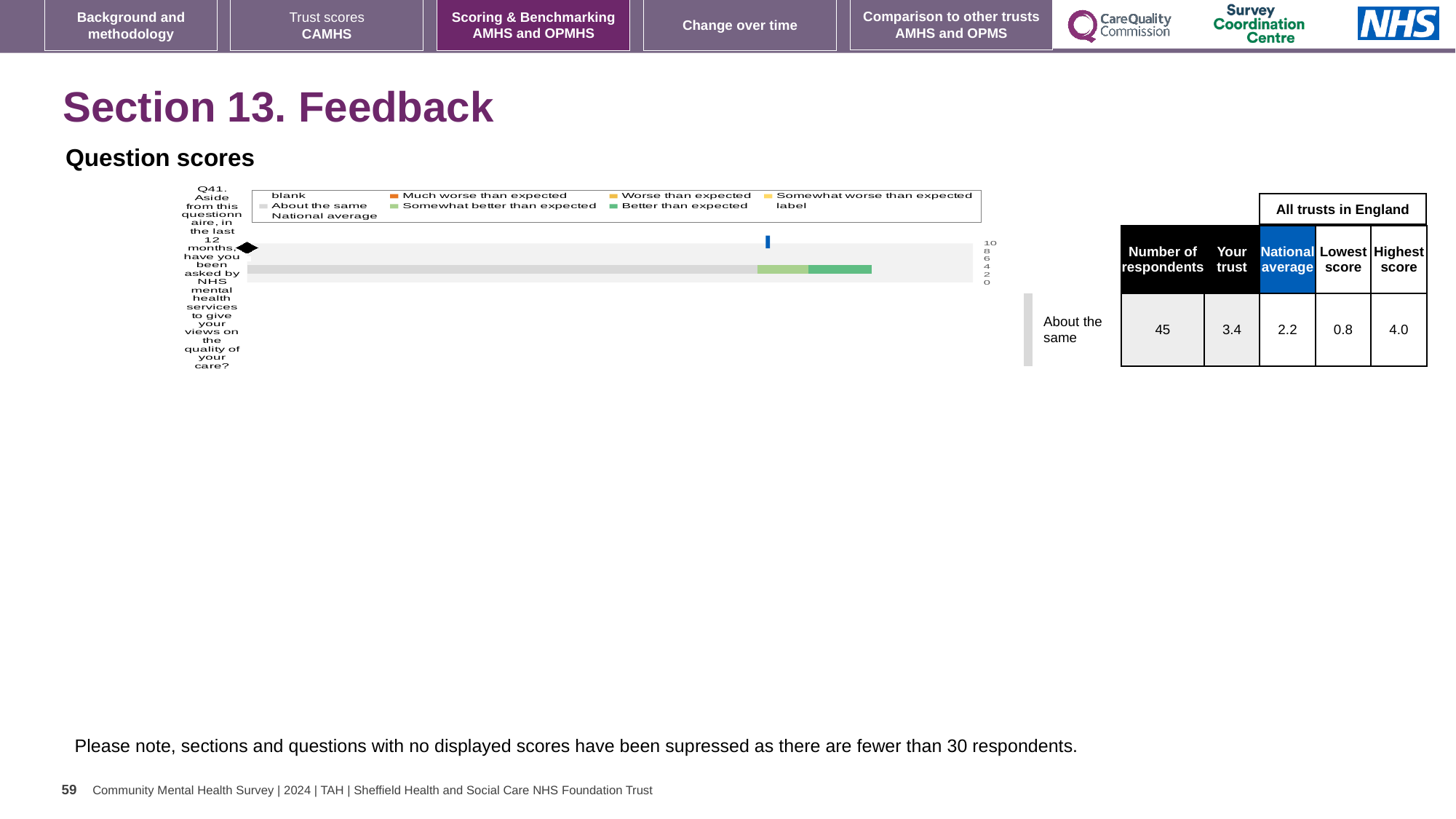
In the table for Q41, what is the highest score among all trusts in England? 4.0 In the table for Q41, what is the lowest score among all trusts in England? 0.8 What benchmark category is shown for Q41 next to the chart? About the same What colour does the legend use for 'Better than expected'? green What kind of chart is used to show the Q41 question score? bar chart For Q41, which is larger: the 'Your trust' score or the national average? Your trust In the table for Q41, what is the national average score? 2.2 Which question is plotted in the Question scores chart? Q41 What is the highest tick value shown on the chart's score axis? 10 In the table for Q41, what is the 'Your trust' score? 3.4 In the table for Q41, what is the number of respondents? 45 How many survey questions are plotted in the Question scores chart? 1